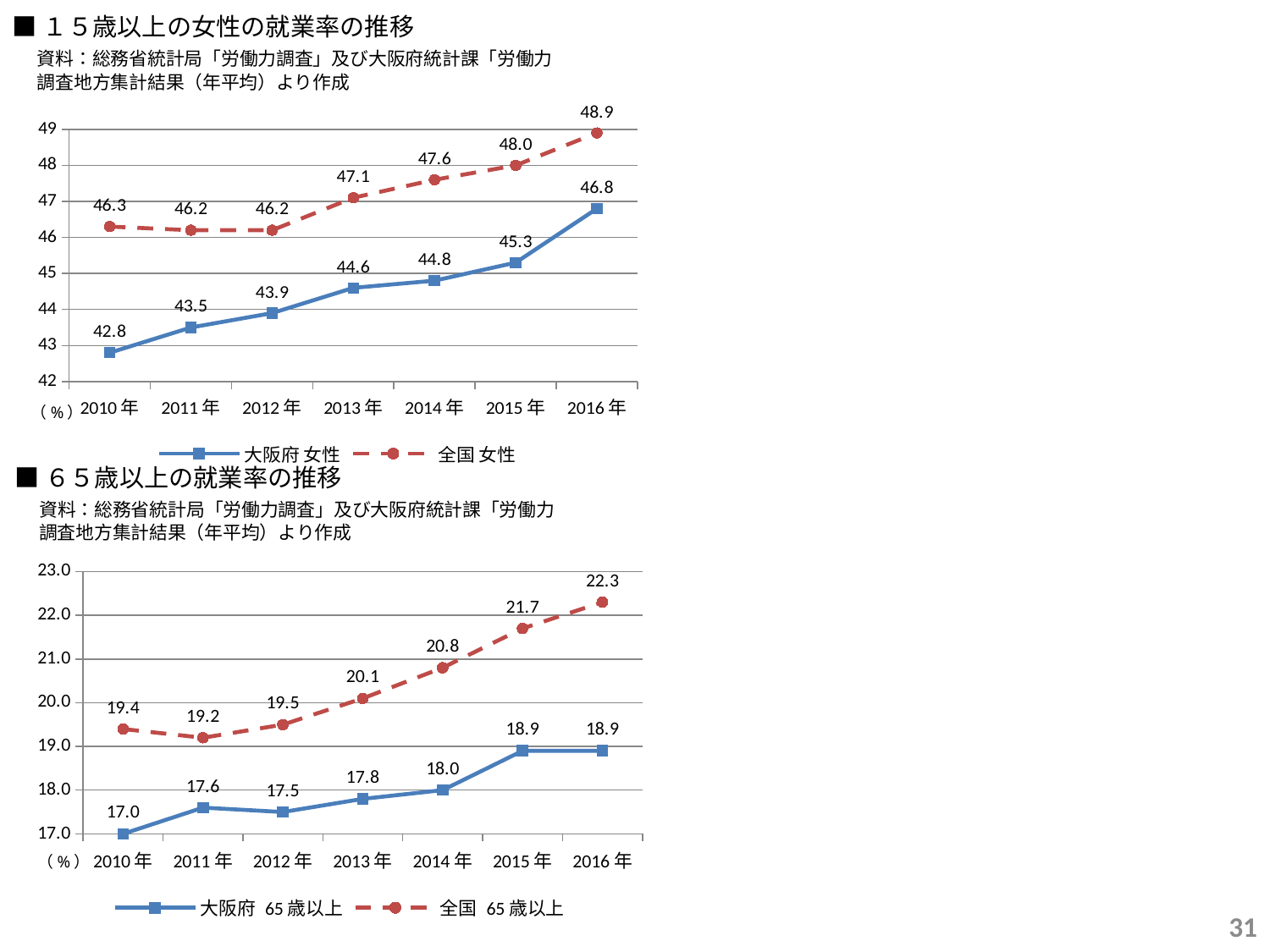
In the bottom chart (65歳以上の就業率の推移), what is the value for 全国 65歳以上 in 2014年? 20.8 In the bottom chart (65歳以上の就業率の推移), what is the value for 大阪府 65歳以上 in 2012年? 17.5 In the bottom chart (65歳以上の就業率の推移), which is larger in 2016年: 大阪府 65歳以上 or 全国 65歳以上? 全国 65歳以上 In the bottom chart (65歳以上の就業率の推移), how many years are shown on the x axis? 7 In the bottom chart (65歳以上の就業率の推移), in which year is the 全国 65歳以上 value lowest? 2011年 In the top chart (15歳以上の女性の就業率の推移), in which year is the 大阪府 女性 value highest? 2016年 In the top chart (15歳以上の女性の就業率の推移), does the 大阪府 女性 line rise or fall from 2010年 to 2016年? rise In the top chart (15歳以上の女性の就業率の推移), how many series does the legend list? 2 In the top chart (15歳以上の女性の就業率の推移), what is the difference between 全国 女性 and 大阪府 女性 in 2013年? 2.5 What type of chart is the bottom chart (65歳以上の就業率の推移)? line chart In the top chart (15歳以上の女性の就業率の推移), what is the value for 大阪府 女性 in 2010年? 42.8 In the top chart (15歳以上の女性の就業率の推移), what is the value for 全国 女性 in 2016年? 48.9